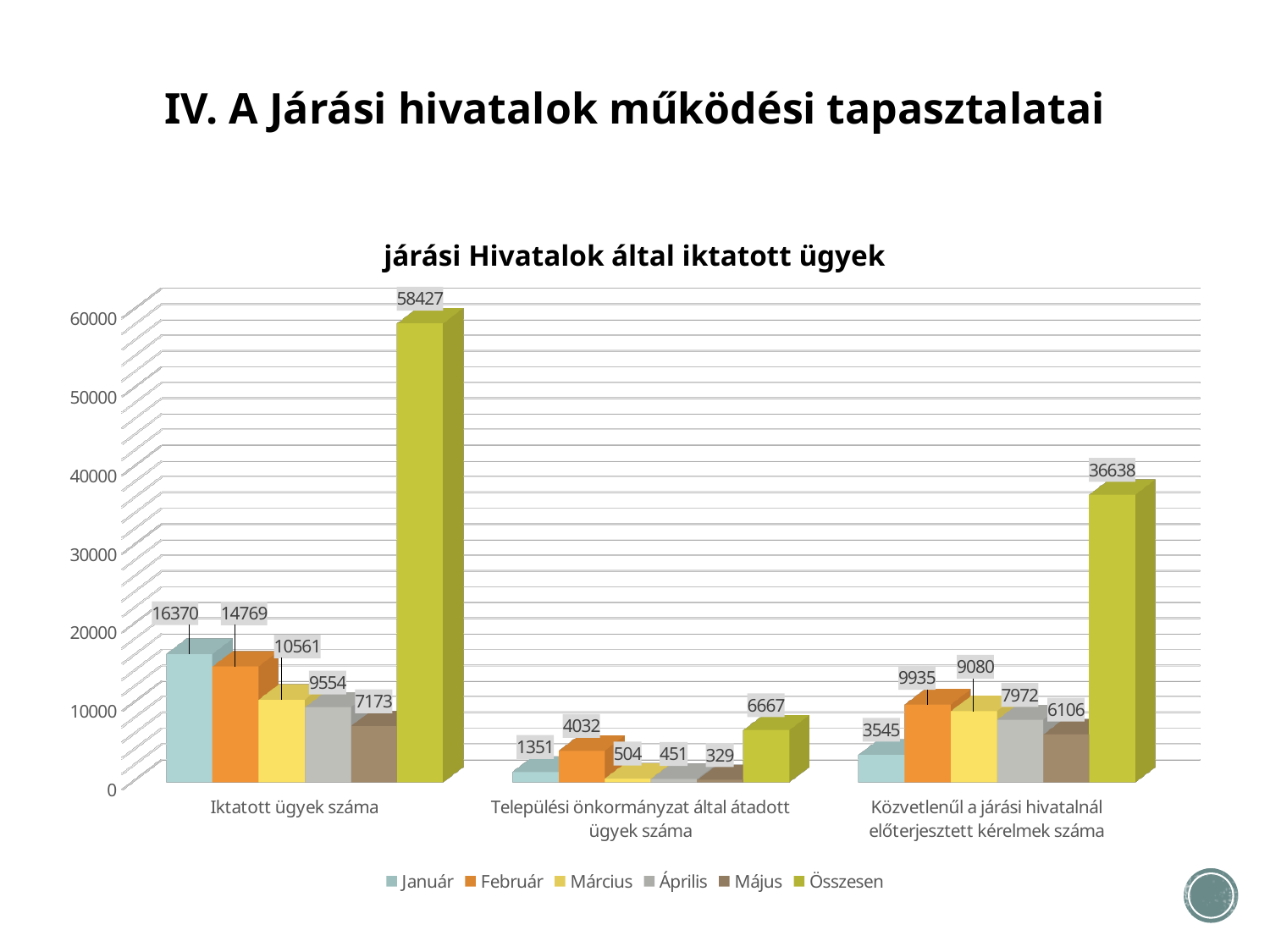
What is the value for Május in the 'Települési önkormányzat által átadott ügyek száma' category? 329 Which month has the lowest value in the 'Közvetlenül a járási hivatalnál előterjesztett kérelmek száma' category? Január What is the difference between the Február and Március values in the 'Iktatott ügyek száma' category? 4208 What is the title of the chart? járási Hivatalok által iktatott ügyek Which is larger in the 'Közvetlenül a járási hivatalnál előterjesztett kérelmek száma' category: Február or Március? Február What is the value for Január in the 'Iktatott ügyek száma' category? 16370 Which category has the highest Összesen value? Iktatott ügyek száma How many categories are shown on the x axis? 3 How many series does the legend list? 6 What is the Összesen value for 'Közvetlenül a járási hivatalnál előterjesztett kérelmek száma'? 36638 Is the Összesen value for 'Iktatott ügyek száma' greater or less than 50000? greater What kind of chart is shown on the slide? bar chart